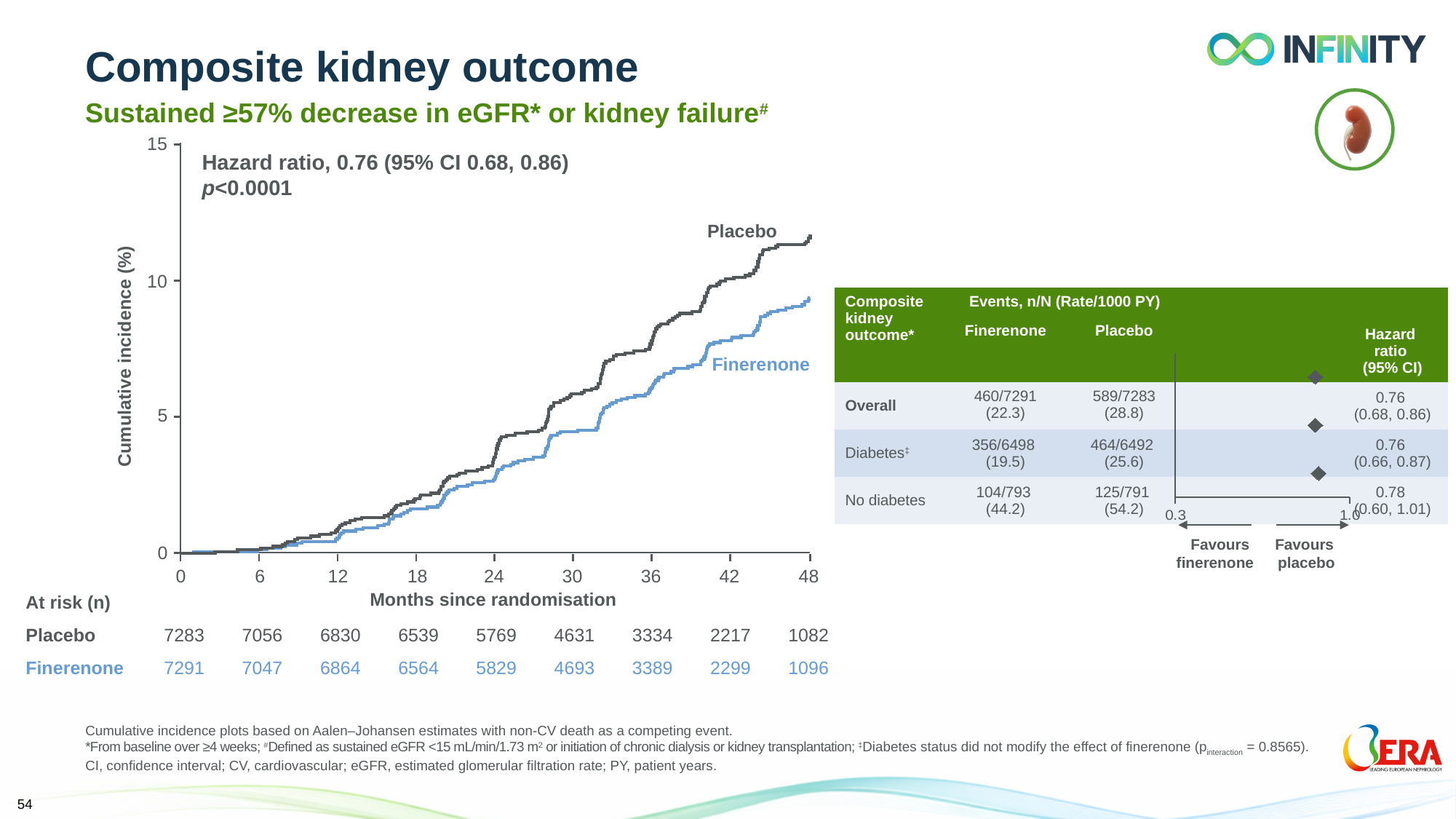
In the forest plot table on the right, which subgroup has the highest hazard ratio? No diabetes In the at-risk table below the cumulative incidence chart, how many Placebo patients were at risk at 24 months? 5769 What kind of chart is the cumulative incidence plot on the left of the slide? Line chart In the at-risk table, what is the difference between the Finerenone and Placebo numbers at risk at 0 months? 8 In the at-risk table below the cumulative incidence chart, how many Finerenone patients were at risk at 48 months? 1096 In the forest plot table on the right, what is the hazard ratio (95% CI) for the No diabetes subgroup? 0.78 (0.60, 1.01) In the cumulative incidence chart, do the curves rise or fall as months since randomisation increase? Rise What hazard ratio and 95% CI are printed on the cumulative incidence chart? 0.76 (95% CI 0.68, 0.86) In the cumulative incidence chart, is the Finerenone cumulative incidence at 48 months greater or less than 10%? less How many treatment groups (series) are plotted in the cumulative incidence chart? 2 In the cumulative incidence chart, is the Placebo cumulative incidence at 48 months greater or less than 10%? greater In the cumulative incidence chart, which group has the higher cumulative incidence at 48 months, Placebo or Finerenone? Placebo